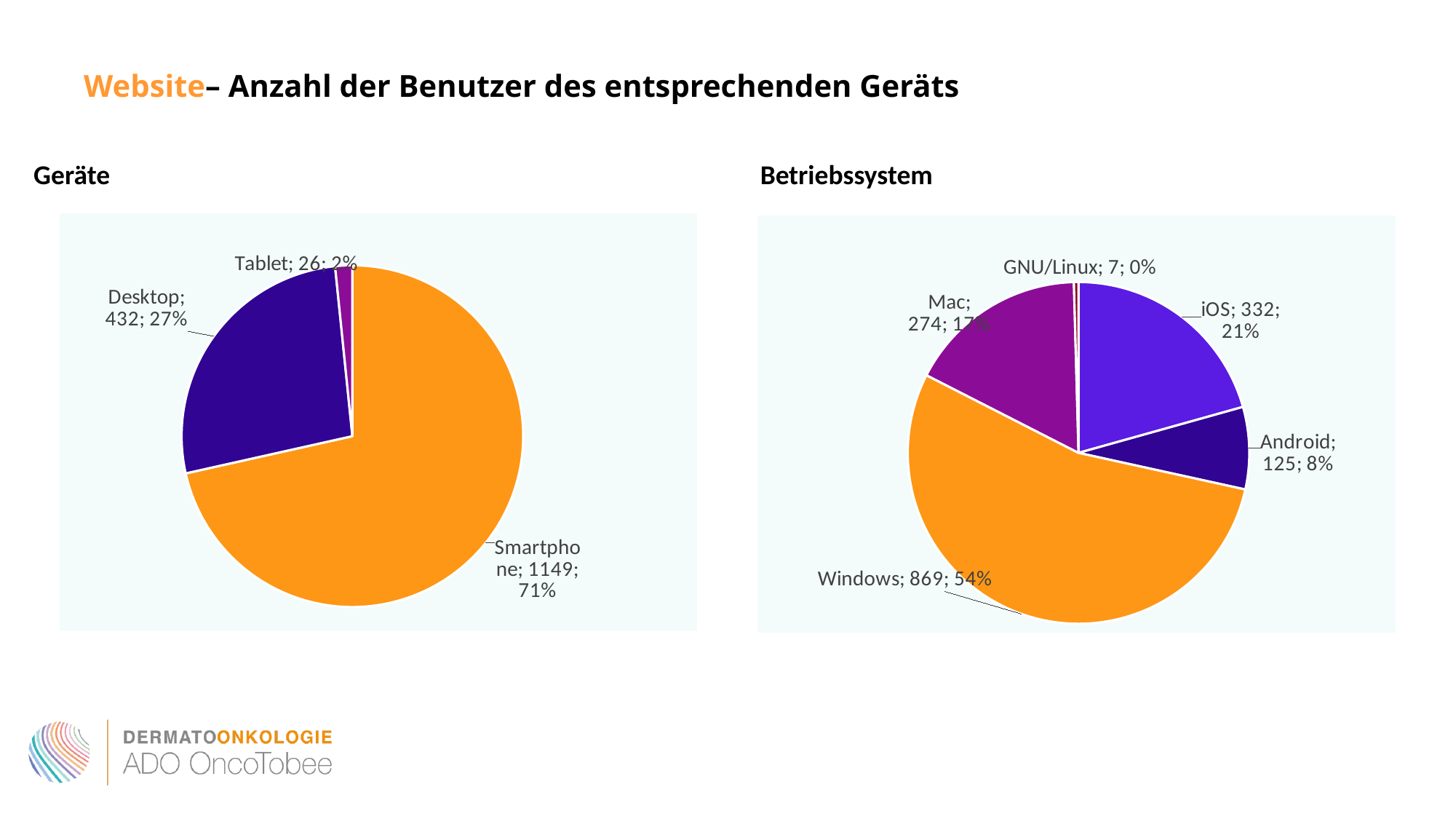
In the Betriebssystem chart, which has more users, Android or Mac? Mac In the Betriebssystem chart, which operating system has the most users? Windows In the Geräte chart, what share of the pie does Smartphone have? 71% What type of chart is the Geräte chart? Pie chart How many slices does the Geräte pie chart have? 3 In the Geräte chart, how many users are shown for Desktop? 432 In the Geräte chart, which device has the fewest users? Tablet In the Betriebssystem chart, what is the difference in users between iOS and Android? 207 In the Geräte chart, what is the difference in users between Smartphone and Desktop? 717 In the Betriebssystem chart, how many users are shown for Mac? 274 In the Betriebssystem chart, what share of the pie does iOS have? 21% How many slices does the Betriebssystem pie chart have? 5